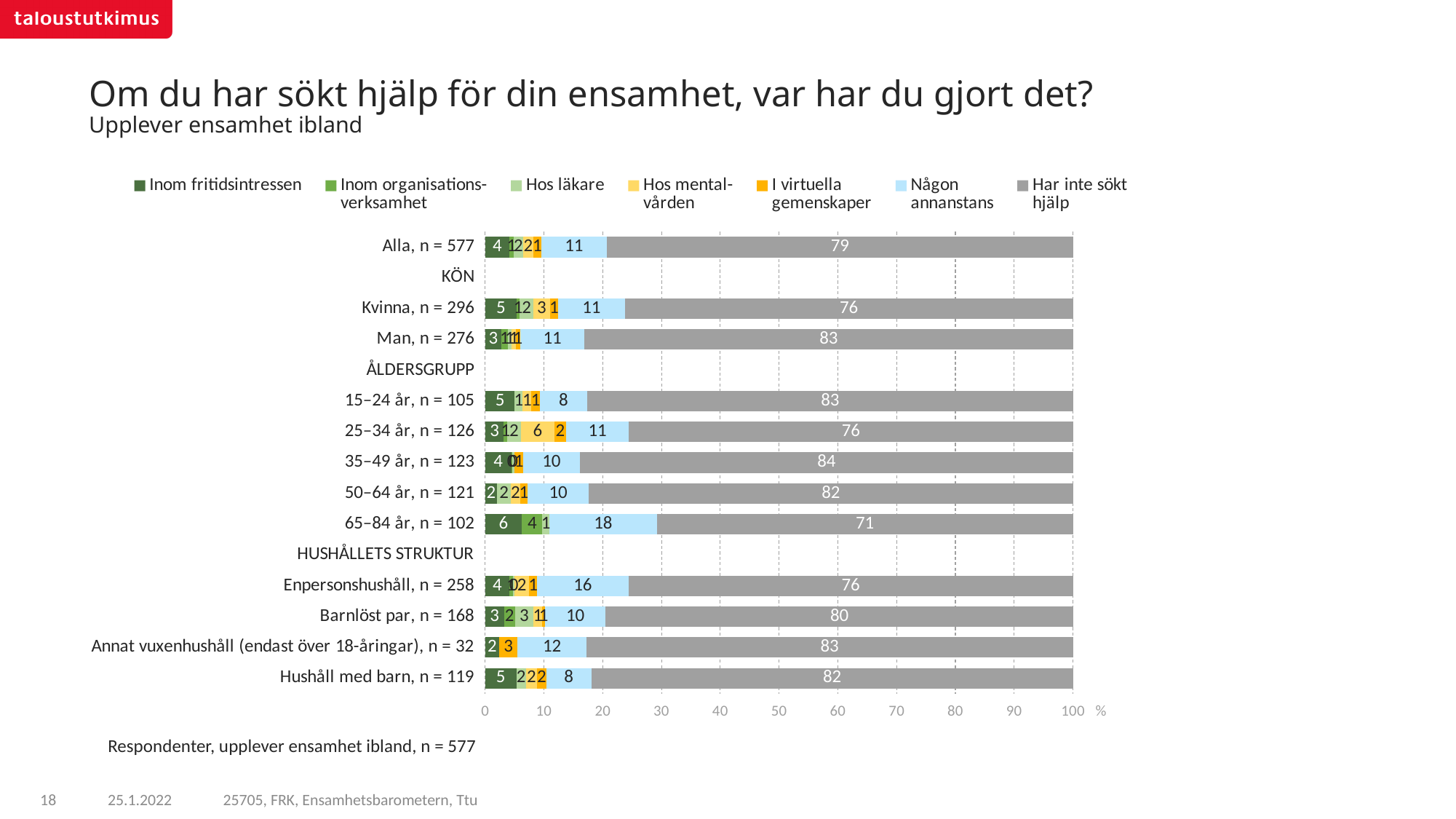
What is the value of "Har inte sökt hjälp" for "Alla, n = 577"? 79 Which group has the highest value for "Har inte sökt hjälp"? 35–49 år, n = 123 Which group has the lowest value for "Har inte sökt hjälp"? 65–84 år, n = 102 What kind of chart is shown on the slide? stacked bar chart What is the difference in "Har inte sökt hjälp" between "Man, n = 276" and "Kvinna, n = 296"? 7 What is the value of "Har inte sökt hjälp" for "Kvinna, n = 296"? 76 What is the value of "Någon annanstans" for "Annat vuxenhushåll (endast över 18-åringar), n = 32"? 12 What is the value of "Någon annanstans" for "65–84 år, n = 102"? 18 What is the value of "Inom fritidsintressen" for "65–84 år, n = 102"? 6 What is the subtitle shown under the chart title? Upplever ensamhet ibland How many series does the legend list? 7 Which has a larger value for "Någon annanstans": "Enpersonshushåll, n = 258" or "Barnlöst par, n = 168"? Enpersonshushåll, n = 258